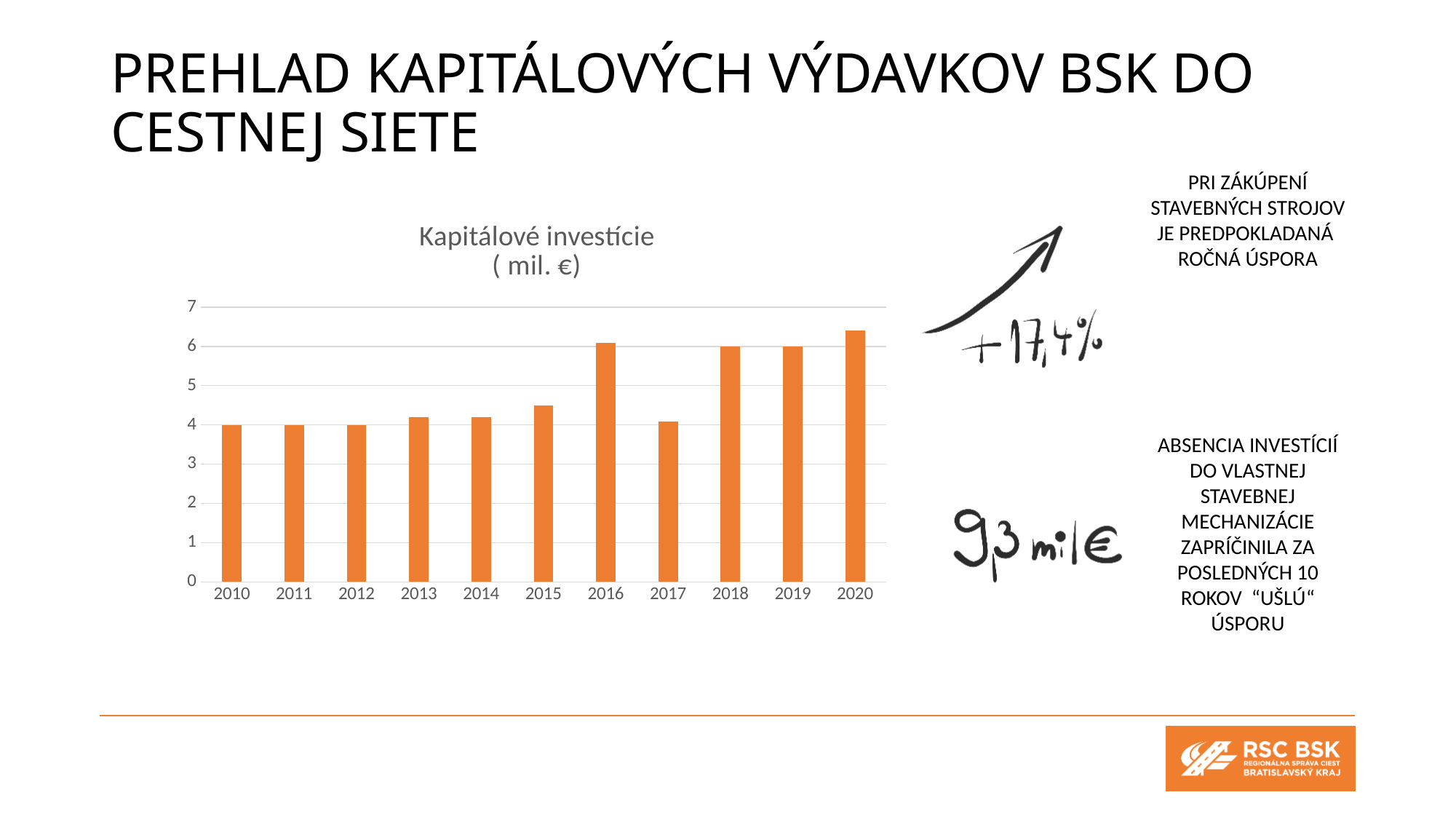
Do the values in the chart generally rise or fall from 2010 to 2020? rise Which year has the highest capital investment in the chart? 2020 Which year has the larger value, 2016 or 2017? 2016 What is the value for 2018 in the chart? 6 Is the value for 2017 greater or less than 5? less What kind of chart is shown on the slide? bar chart What is the value for 2019 in the chart? 6 Is the value for 2015 greater or less than 5? less What is the title of the chart? Kapitálové investície ( mil. €) How many years are shown on the x axis of the chart? 11 What is the value for 2010 in the chart? 4 Is the value for 2016 greater or less than 5? greater